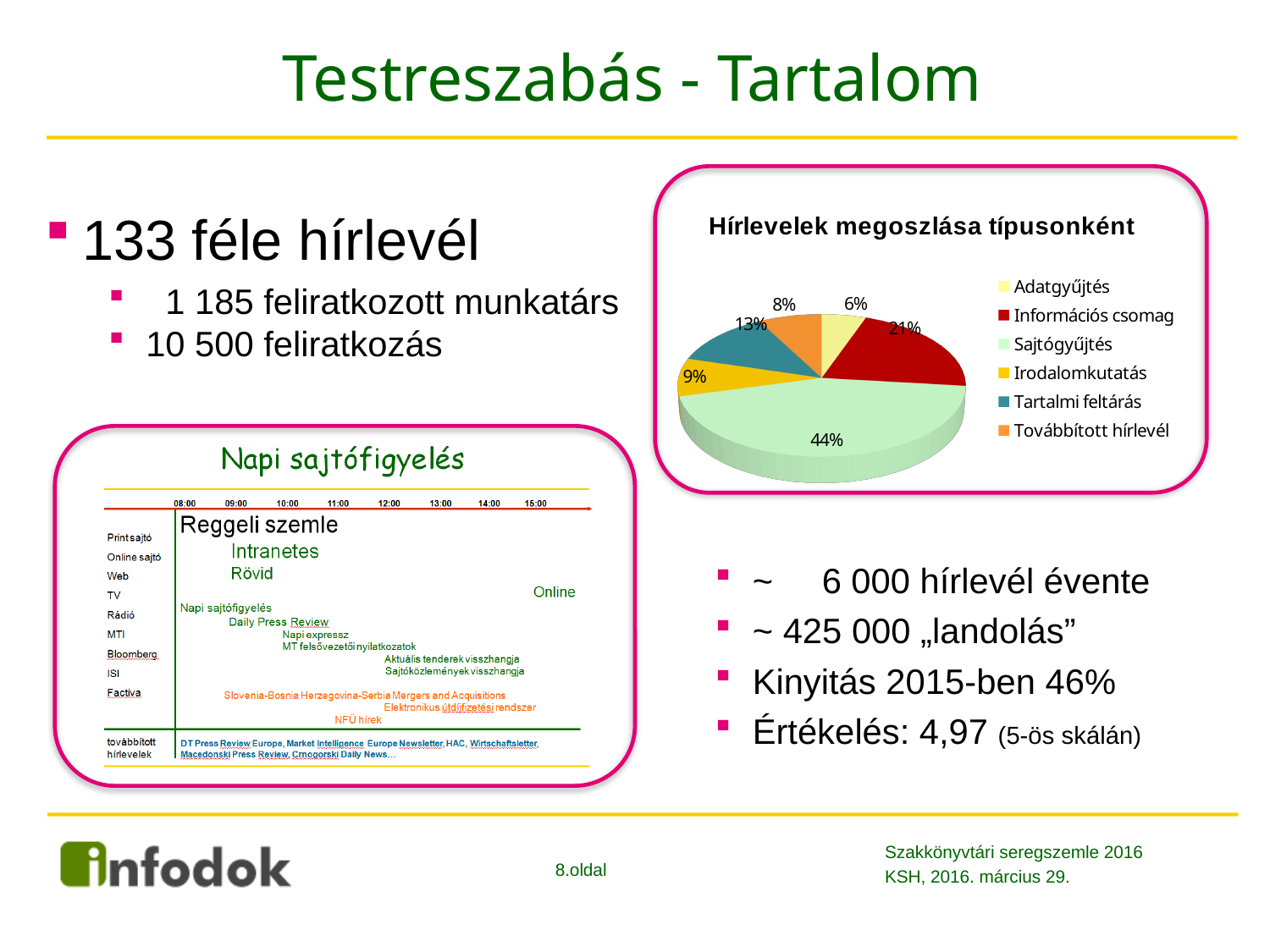
In the pie chart "Hírlevelek megoszlása típusonként", how many percentage points larger is Sajtógyűjtés than Információs csomag? 23 In the pie chart "Hírlevelek megoszlása típusonként", which is larger: Tartalmi feltárás or Irodalomkutatás? Tartalmi feltárás In the pie chart "Hírlevelek megoszlása típusonként", what share does Irodalomkutatás have? 9% In the pie chart "Hírlevelek megoszlása típusonként", what share does Információs csomag have? 21% What type of chart is shown under the title "Hírlevelek megoszlása típusonként"? pie chart How many categories does the legend of the pie chart "Hírlevelek megoszlása típusonként" list? 6 In the pie chart "Hírlevelek megoszlása típusonként", which colour represents Információs csomag? dark red In the pie chart "Hírlevelek megoszlása típusonként", what share does Tartalmi feltárás have? 13% In the pie chart "Hírlevelek megoszlása típusonként", what share does Továbbított hírlevél have? 8% In the pie chart "Hírlevelek megoszlása típusonként", which category has the smallest share? Adatgyűjtés In the pie chart "Hírlevelek megoszlása típusonként", what share does Sajtógyűjtés have? 44% In the pie chart "Hírlevelek megoszlása típusonként", which category has the largest share? Sajtógyűjtés